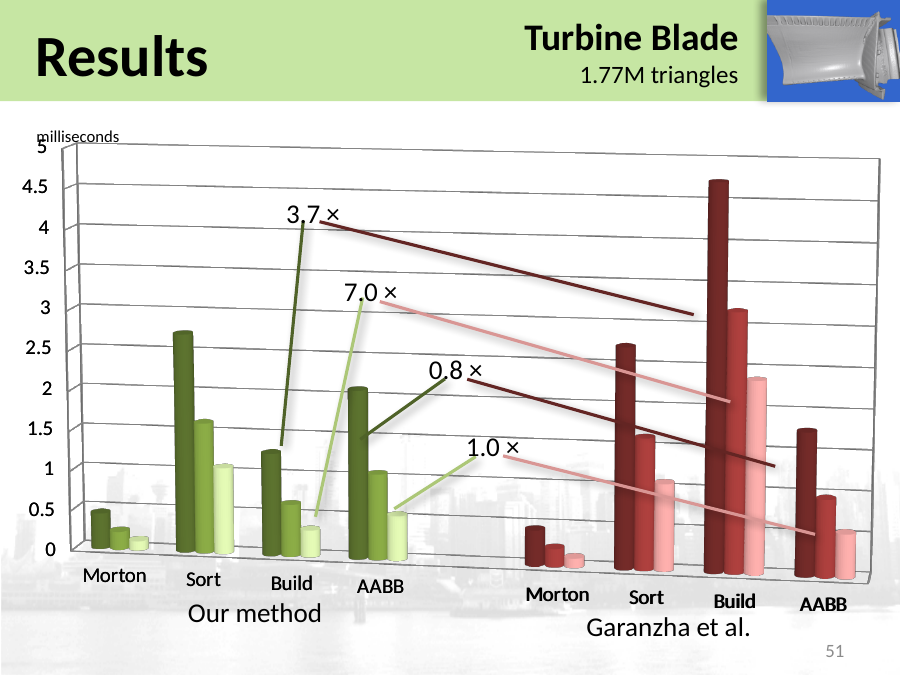
Which category in the "Garanzha et al." group has the tallest bar? Build How many bars are plotted for each category? 3 How many categories are labelled under the "Our method" group? 4 What kind of chart is shown on the slide? bar chart Which category in the "Our method" group has the tallest bar? Sort Is the tallest Sort bar for "Our method" greater or less than 2 milliseconds? greater What unit is shown on the vertical axis of the chart? milliseconds What speed-up factor is annotated for the Build category? 3.7 × and 7.0 × Is the tallest Morton bar for "Our method" greater or less than 1 millisecond? less Which category in the "Our method" group has the shortest bars? Morton Which is taller: the tallest Build bar for "Our method" or the tallest Build bar for "Garanzha et al."? Garanzha et al. Is the tallest Build bar for "Garanzha et al." greater or less than 4 milliseconds? greater